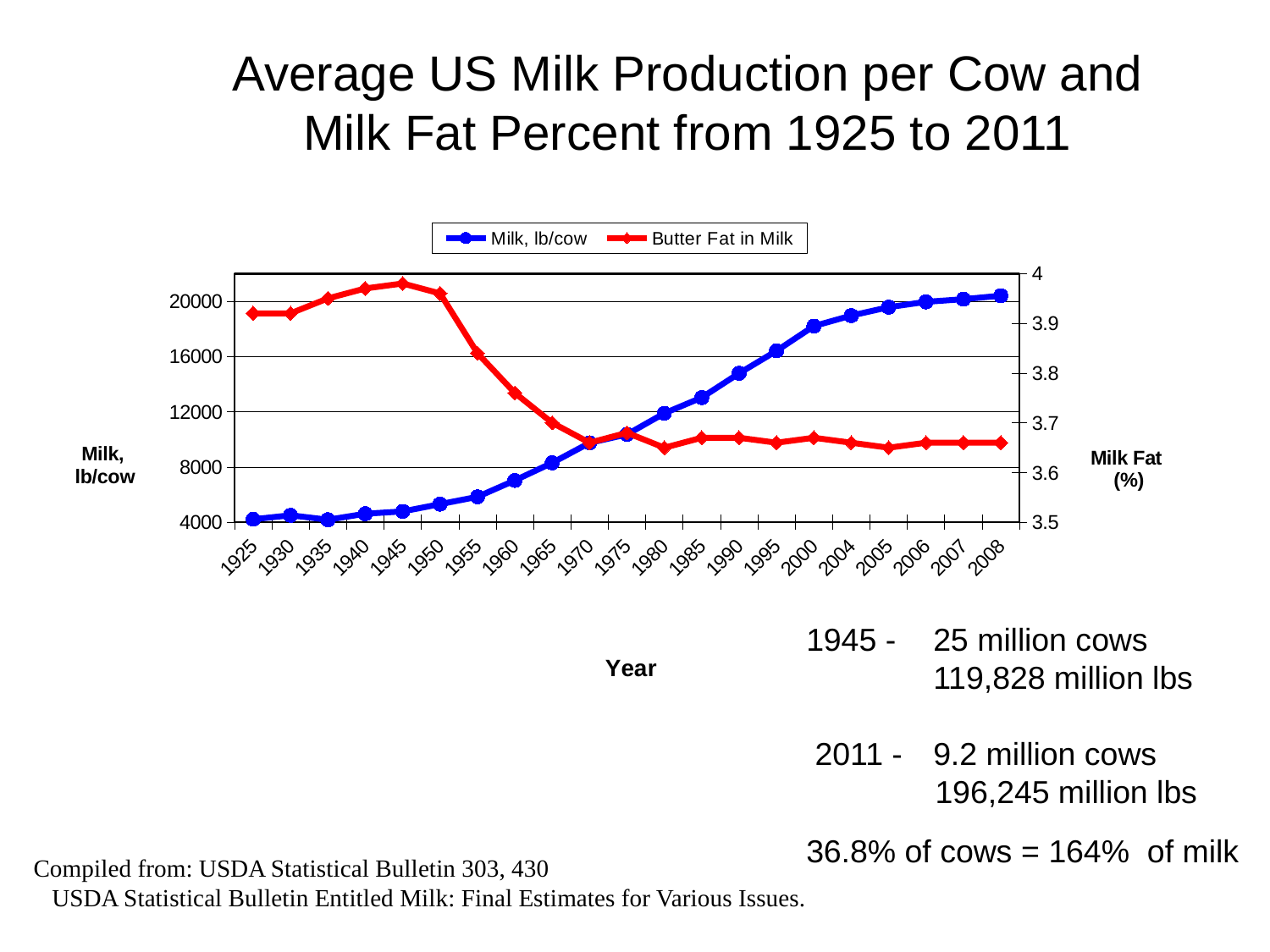
Is the Butter Fat in Milk value for 1980 greater or less than 3.7? less How many series does the legend list? 2 Does the Milk, lb/cow series generally rise or fall from 1925 to 2008? rise Is the Milk, lb/cow value for 2000 greater or less than 16000? greater What is the label on the right-hand vertical axis? Milk Fat (%) In which year does the Butter Fat in Milk series reach its highest value? 1945 In which year does the Milk, lb/cow series reach its highest value? 2008 Is the Milk, lb/cow value for 1960 greater or less than 8000? less How many years are plotted along the x axis? 21 Which year has the larger Milk, lb/cow value, 1975 or 1995? 1995 What kind of chart is shown on the slide? line chart